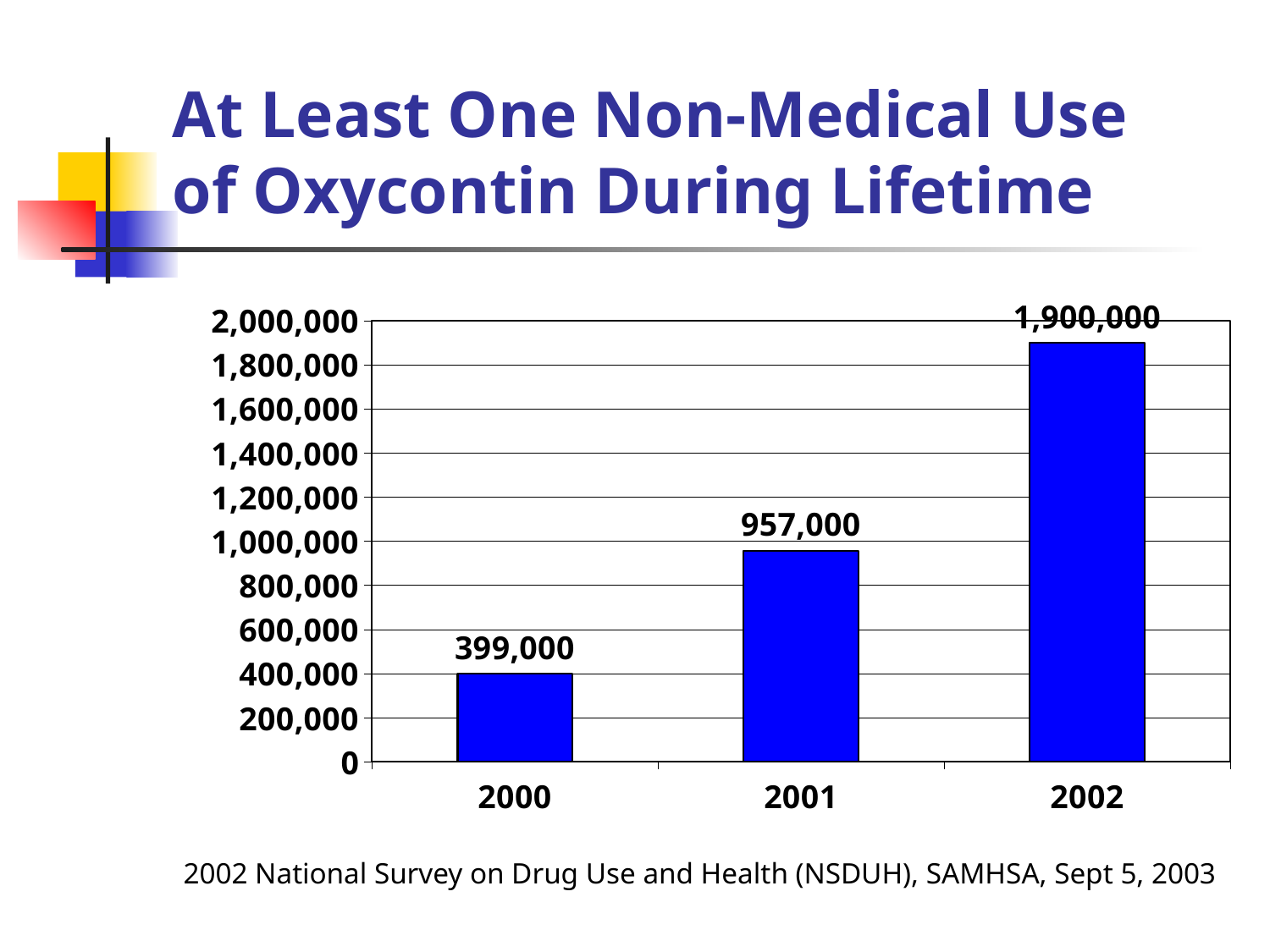
Is the value for 2001 greater or less than 1,000,000? less What is the value for 2001? 957,000 What kind of chart is shown on the slide? bar chart How many years are shown on the x axis? 3 What is the value for 2000? 399,000 Which year has the lowest value? 2000 What is the value for 2002? 1,900,000 Which is larger, the value for 2001 or the value for 2000? 2001 What is the difference between the values for 2002 and 2001? 943,000 Which year has the highest value? 2002 What is the difference between the values for 2001 and 2000? 558,000 Do the values rise or fall from 2000 to 2002? rise